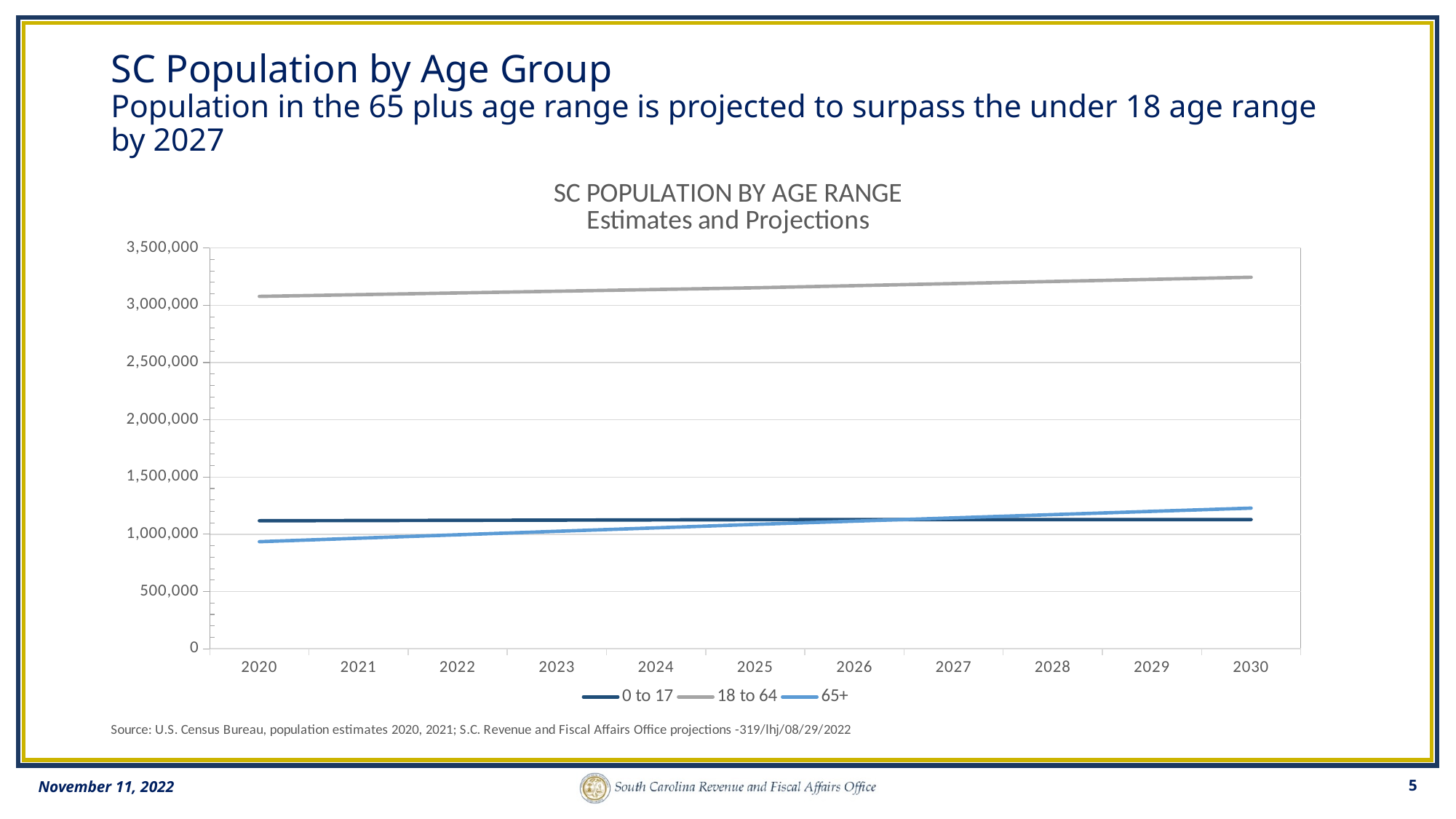
Which age group has the highest population across all years? 18 to 64 In 2030, which is larger: the 65+ group or the 0 to 17 group? 65+ What kind of chart is shown on the slide? line chart In 2020, which is larger: the 0 to 17 group or the 65+ group? 0 to 17 What is the title of the chart? SC POPULATION BY AGE RANGE Estimates and Projections Is the value for the 65+ group in 2020 greater or less than 1,000,000? less Is the value for the 18 to 64 group in 2020 greater or less than 3,000,000? greater Which age group has the lowest population in 2020? 65+ Is the value for the 65+ group in 2030 greater or less than 1,000,000? greater How many years are shown along the x axis? 11 Does the 65+ line rise or fall from 2020 to 2030? rise How many series does the legend list? 3